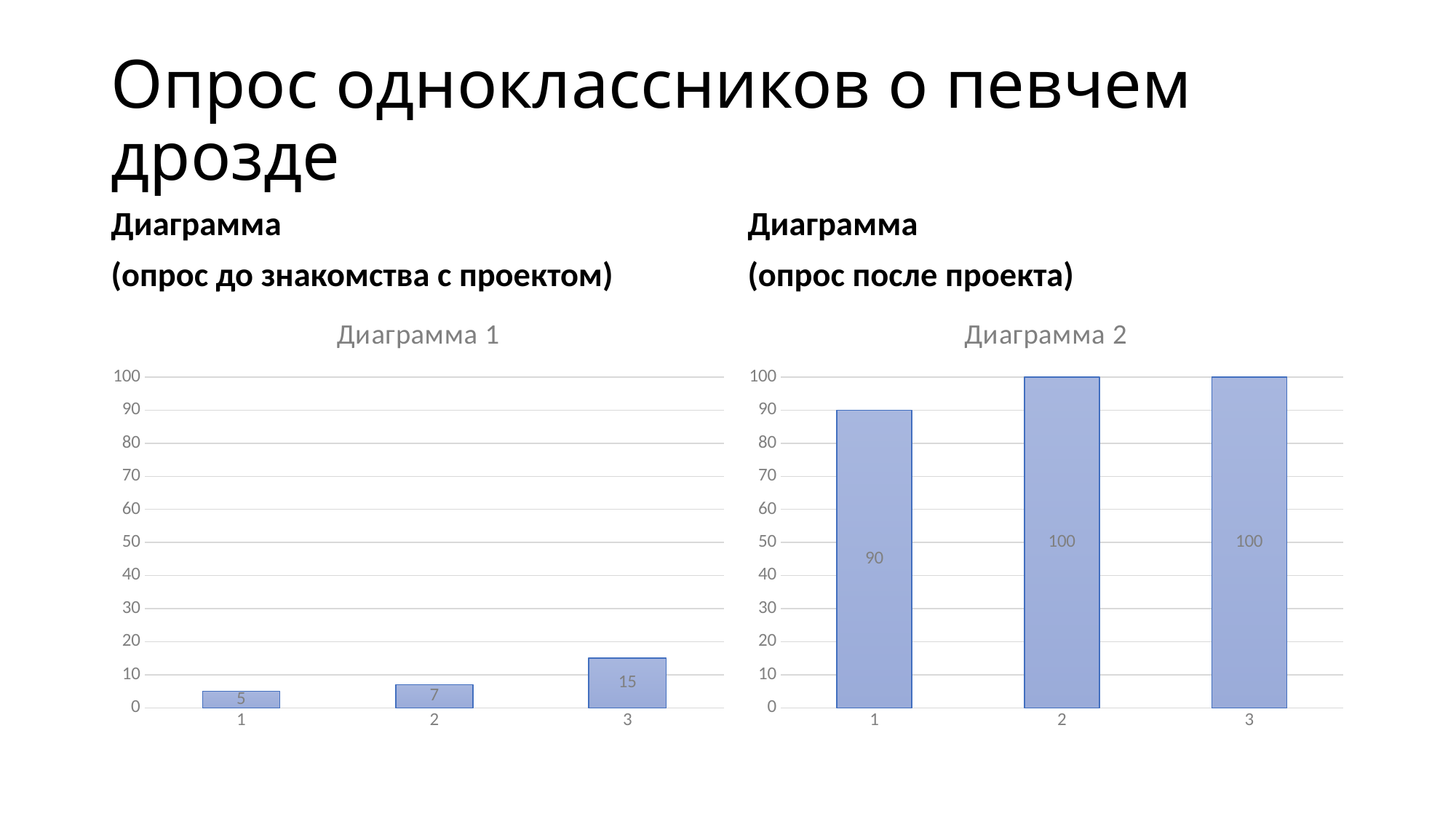
In the chart titled "Диаграмма 2", which category has the lowest value? 1 In the chart titled "Диаграмма 2", what is the difference between the values for category 2 and category 1? 10 In the chart titled "Диаграмма 1", which category has the highest value? 3 In the chart titled "Диаграмма 2", what is the value for category 1? 90 In the chart titled "Диаграмма 1", what is the difference between the values for category 3 and category 2? 8 In the chart titled "Диаграмма 1", which is larger: the value for category 2 or category 3? 3 In the chart titled "Диаграмма 1", which category has the lowest value? 1 In the chart titled "Диаграмма 1", do the values rise or fall from category 1 to category 3? rise In the chart titled "Диаграмма 1", what is the value for category 1? 5 How many categories are shown in the chart titled "Диаграмма 2"? 3 What kind of chart is the chart titled "Диаграмма 1"? bar chart In the chart titled "Диаграмма 1", what is the value for category 3? 15